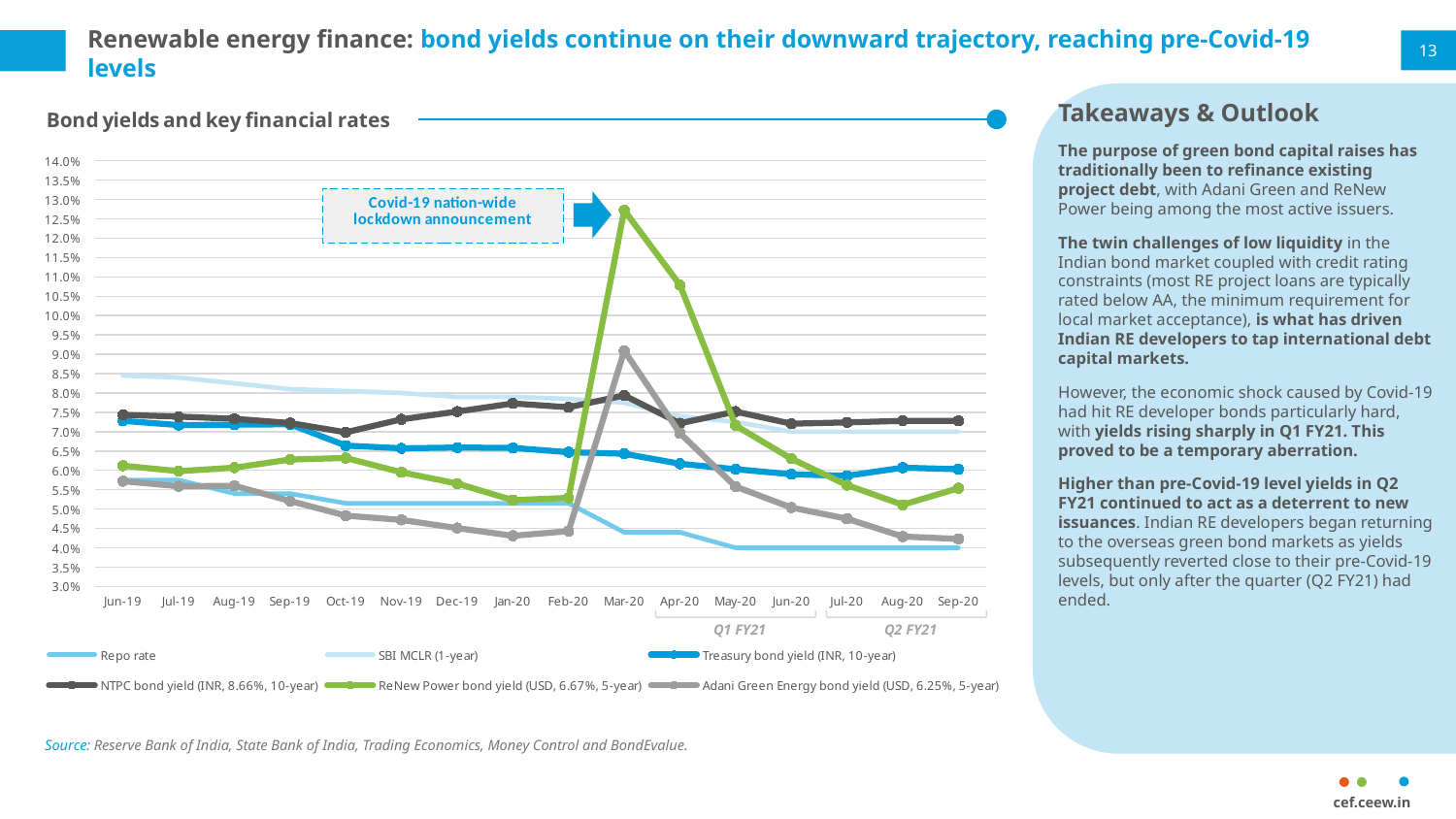
Which series reaches the highest value anywhere on the chart? ReNew Power bond yield (USD, 6.67%, 5-year) Is the Adani Green Energy bond yield in Mar-20 greater or less than 8.5%? greater Is the ReNew Power bond yield in Mar-20 greater or less than 12.0%? greater Is the Repo rate in Sep-20 greater or less than 4.5%? less What is the title of the chart? Bond yields and key financial rates How many months are plotted along the x axis of the chart? 16 Does the Repo rate rise or fall from Jun-19 to Sep-20? Fall In which month does the ReNew Power bond yield reach its highest value? Mar-20 How many series does the chart legend list? 6 What kind of chart is shown on the slide? Line chart What event does the annotation box on the chart describe? Covid-19 nation-wide lockdown announcement In Mar-20, which is higher: the ReNew Power bond yield or the Adani Green Energy bond yield? ReNew Power bond yield